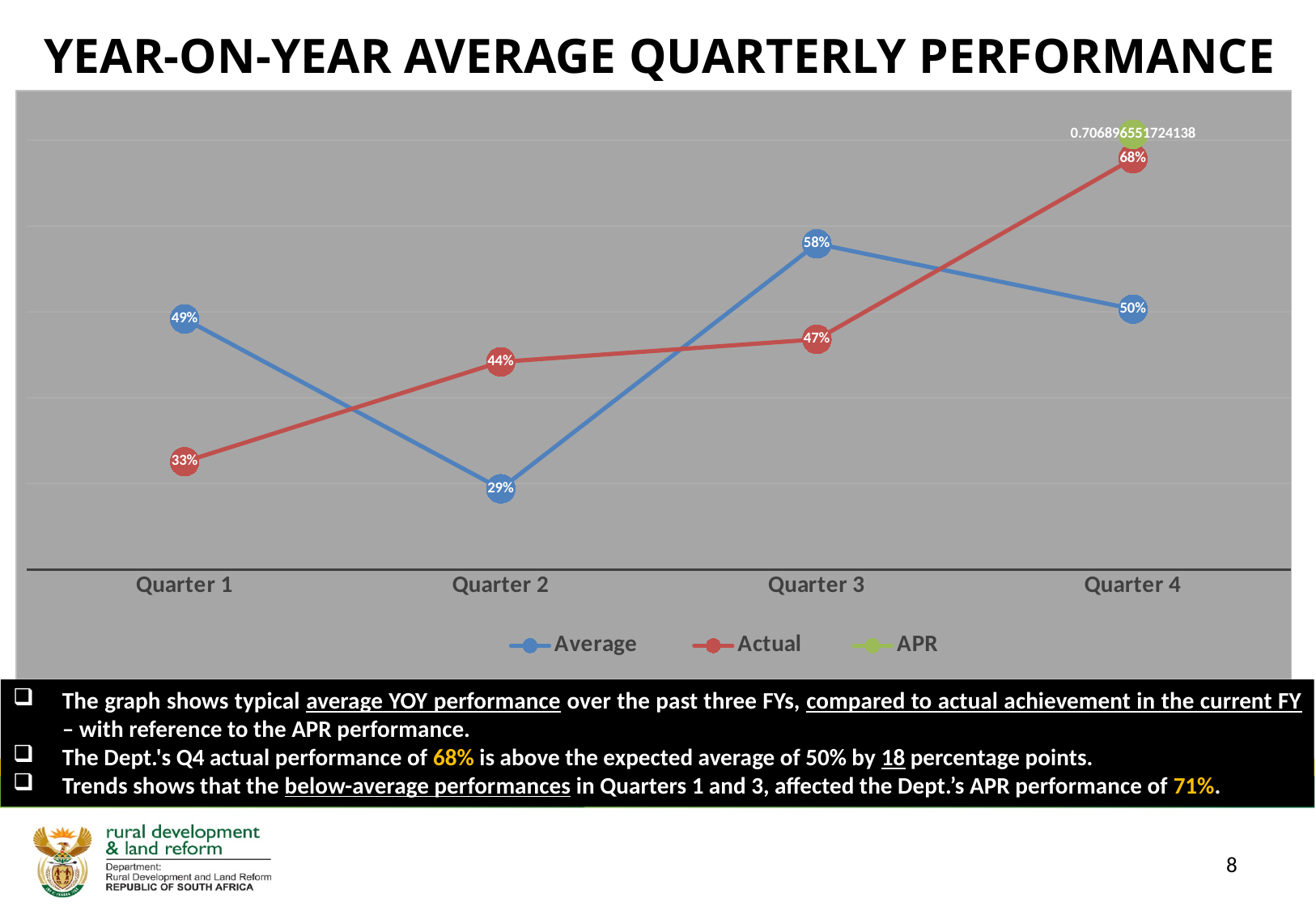
What is the difference between the Actual and Average values in Quarter 4? 18 percentage points What is the Average value for Quarter 1? 49% Does the Actual series rise or fall from Quarter 1 to Quarter 4? Rise What is the Average value for Quarter 3? 58% In which quarter is the Average series lowest? Quarter 2 How many series does the legend list? 3 How many quarters are shown on the x axis? 4 In which quarter is the Actual series highest? Quarter 4 What is the Actual value for Quarter 2? 44% What is the Actual value for Quarter 4? 68% Which is larger in Quarter 3, the Average value or the Actual value? Average What kind of chart is shown on the slide? Line chart